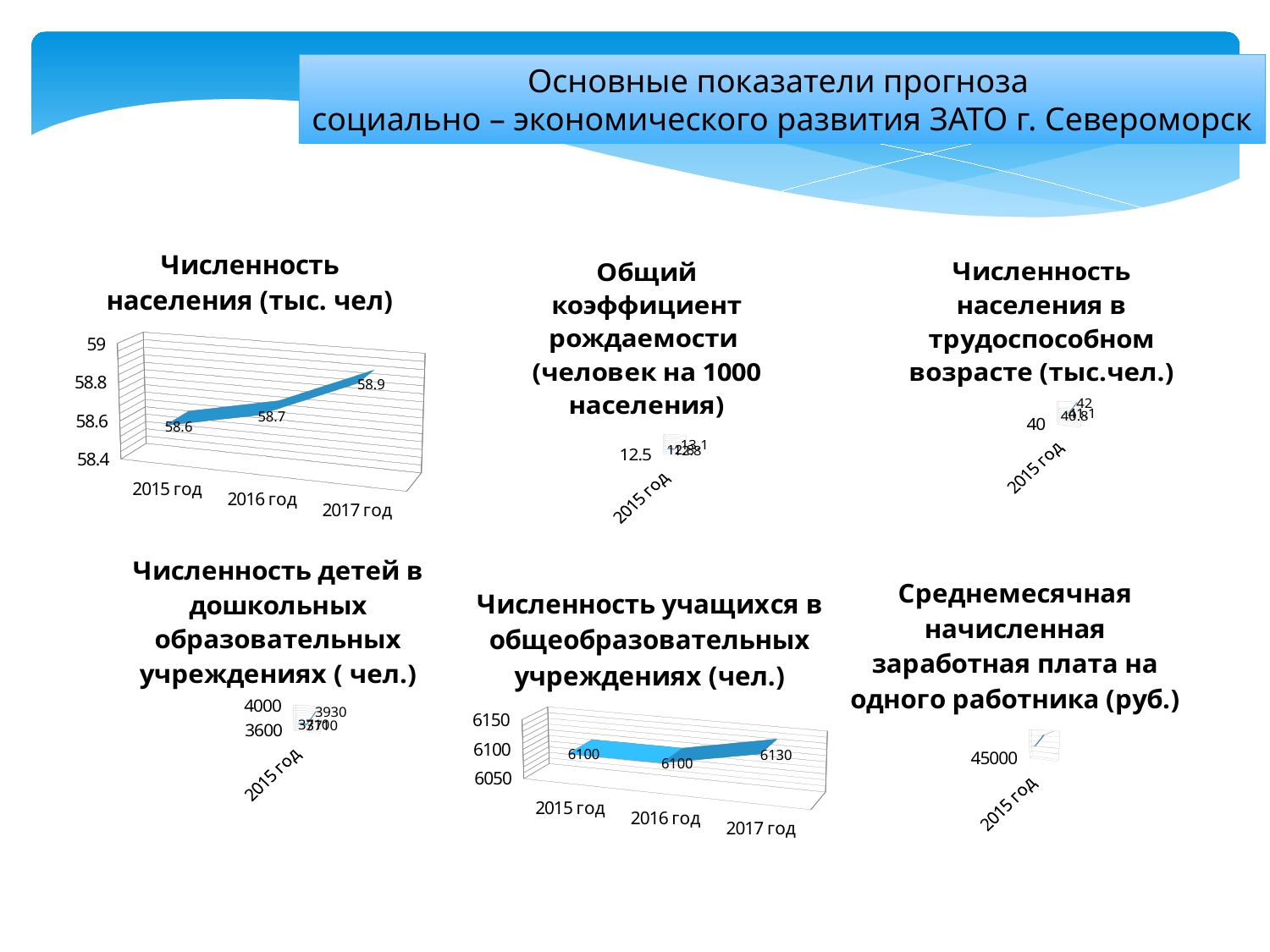
In the chart titled "Численность населения (тыс. чел)", how many years are plotted? 3 In the chart titled "Численность населения (тыс. чел)", do the values rise or fall from 2015 год to 2017 год? rise In the chart titled "Численность населения (тыс. чел)", which year has the highest value? 2017 год In the chart titled "Численность населения (тыс. чел)", what is the difference between the values for 2017 год and 2015 год? 0.3 In the chart titled "Численность учащихся в общеобразовательных учреждениях (чел.)", what is the value for 2017 год? 6130 In the chart titled "Численность учащихся в общеобразовательных учреждениях (чел.)", is the value for 2017 год larger or smaller than the value for 2015 год? larger In the chart titled "Численность учащихся в общеобразовательных учреждениях (чел.)", what is the value for 2016 год? 6100 In the chart titled "Численность учащихся в общеобразовательных учреждениях (чел.)", which year has the highest value? 2017 год In the chart titled "Численность учащихся в общеобразовательных учреждениях (чел.)", what is the difference between the values for 2017 год and 2015 год? 30 In the chart titled "Численность населения (тыс. чел)", what is the value for 2017 год? 58.9 In the chart titled "Численность населения (тыс. чел)", which year has the lowest value? 2015 год In the chart titled "Численность населения (тыс. чел)", what is the value for 2015 год? 58.6